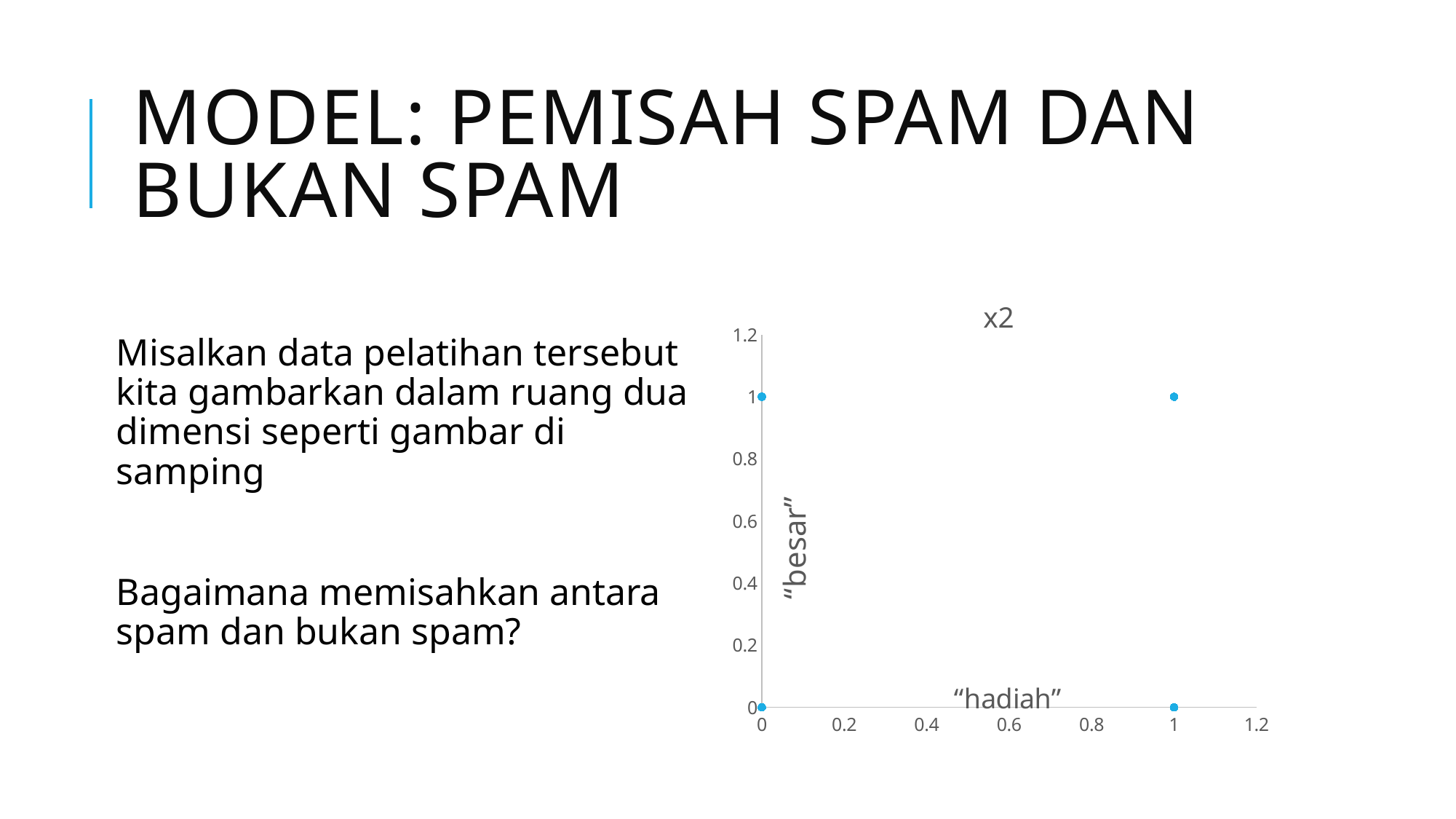
What is the label on the horizontal axis of the chart? "hadiah" How many plotted points have a "hadiah" value of 1? 2 How many plotted points have a "besar" value of 0? 2 What is the highest value shown on the horizontal axis of the chart? 1.2 What is the largest "besar" (vertical) value among the plotted points? 1 What is the highest value shown on the vertical axis of the chart? 1.2 Is the "besar" value of the point at "hadiah" = 1 with the higher position greater or less than 0.8? greater What is the smallest "hadiah" (horizontal) value among the plotted points? 0 How many data points are plotted on the chart? 4 What is the title of the chart? x2 What is the difference between the largest and smallest "besar" values of the plotted points? 1 What kind of chart is shown on the slide? scatter chart